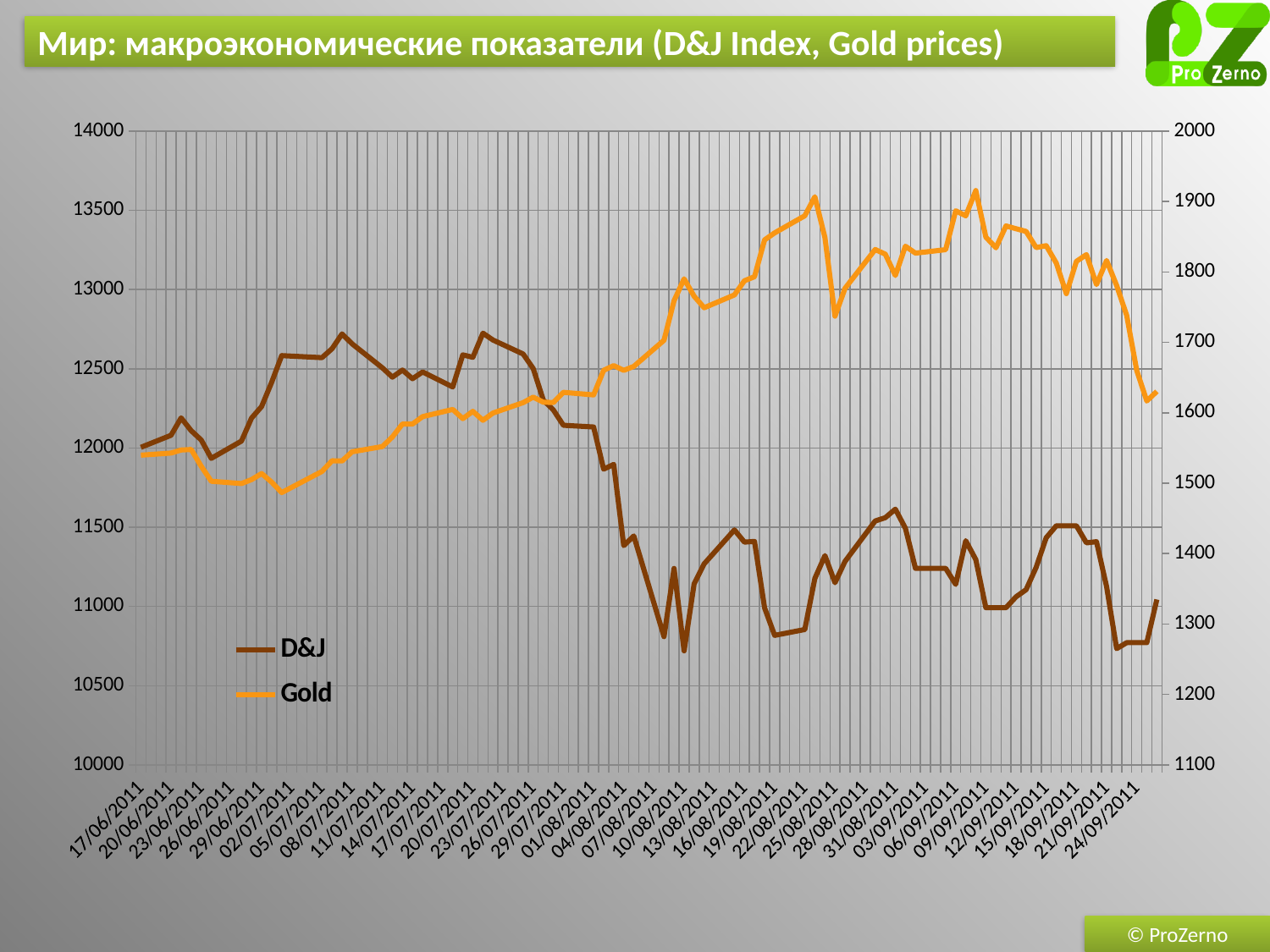
Is the Gold value on 25/08/2011 greater or less than 1800? less How many series does the legend list? 2 Does the Gold series rise or fall from 17/06/2011 to 25/08/2011? rise What are the two series named in the legend? D&J and Gold Does the D&J series overall rise or fall from 17/06/2011 to 24/09/2011? fall Which is larger: the D&J value on 08/07/2011 or on 24/09/2011? 08/07/2011 Is the Gold value on 17/06/2011 greater or less than 1600? less Is the D&J value on 10/08/2011 greater or less than 11000? less What kind of chart is shown on the slide? line chart Which series is drawn in orange? Gold